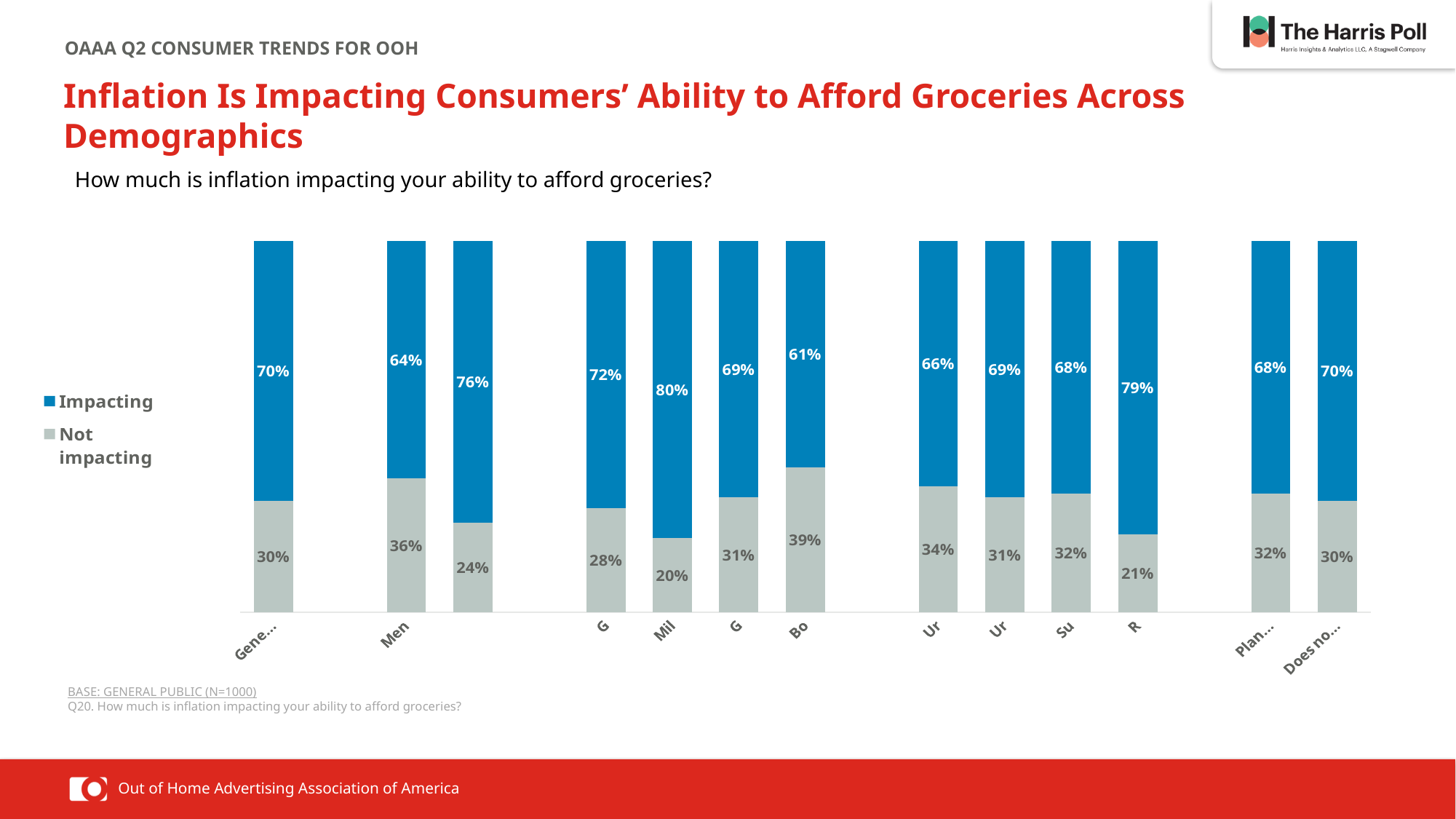
What is the Not impacting value for Men? 36% What kind of chart is shown on the slide? Stacked bar chart What is the Impacting value for Men? 64% For Men, how many percentage points higher is Impacting than Not impacting? 28 percentage points What is the total of the Men bar (Impacting plus Not impacting)? 100% Is the Impacting value for Men larger or smaller than the Impacting value of the bar immediately to its right? smaller How many bars are plotted in the chart? 13 What is the highest Impacting value shown on any bar? 80% How many series does the legend list? 2 What is the lowest Impacting value shown on any bar? 61% What are the two legend entries? Impacting; Not impacting What is the highest Not impacting value shown on any bar? 39%